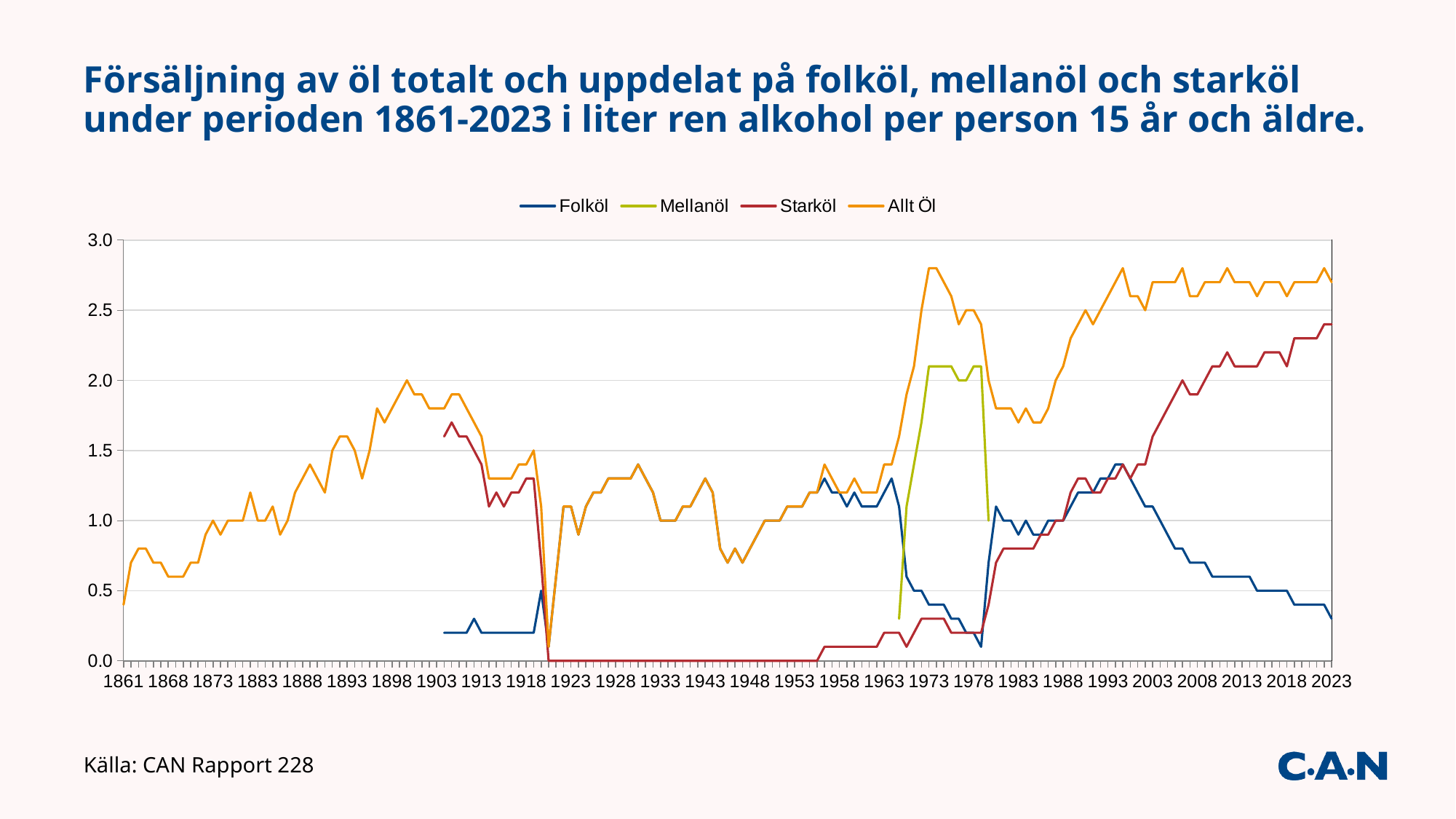
Which series has the highest value in 2023? Allt Öl Is the value for Folköl in 2023 greater or less than 0.5? less In 2023, which is larger, Starköl or Folköl? Starköl What kind of chart is shown on the slide? Line chart Does the Folköl line rise or fall from 1993 to 2023? Fall How many series does the legend list? 4 What is the value for Starköl in 1943? 0.0 Which series is drawn in green in the legend? Mellanöl Is the value for Allt Öl in 2023 greater or less than 2.5? greater What is the source cited below the chart? CAN Rapport 228 Is the value for Allt Öl in 1861 greater or less than 0.5? less